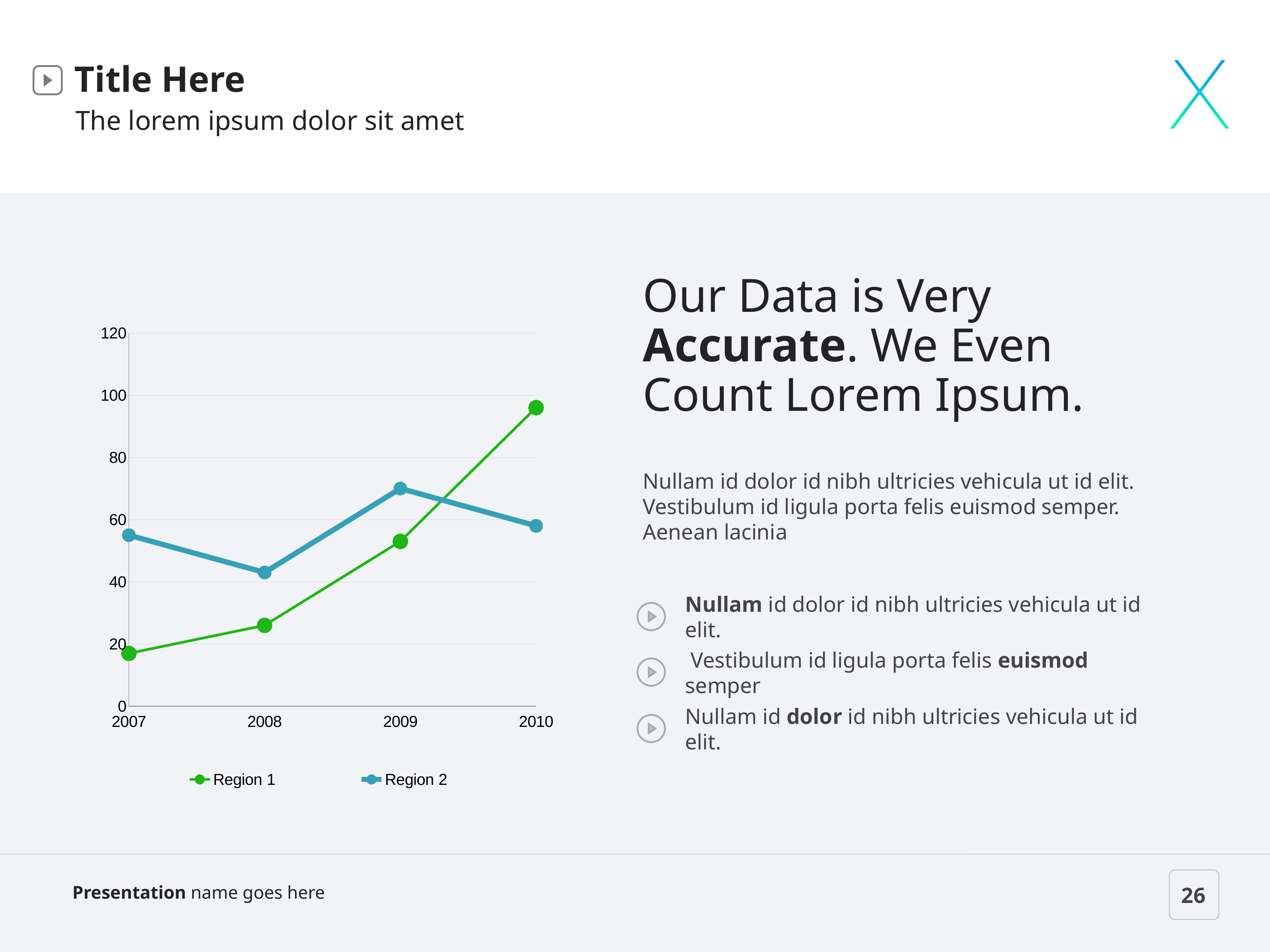
In 2009, which series has the larger value, Region 1 or Region 2? Region 2 What kind of chart is shown on the slide? line chart In which year is Region 2 at its lowest? 2008 In which year is Region 1 at its highest? 2010 How many years are shown on the x axis of the chart? 4 In 2010, which series has the larger value, Region 1 or Region 2? Region 1 Does the Region 1 line rise or fall from 2007 to 2010? rises How many series does the chart's legend list? 2 Is the value for Region 1 in 2010 greater or less than 80? greater Is the value for Region 1 in 2009 greater or less than 40? greater In which year is Region 1 at its lowest? 2007 In which year is Region 2 at its highest? 2009